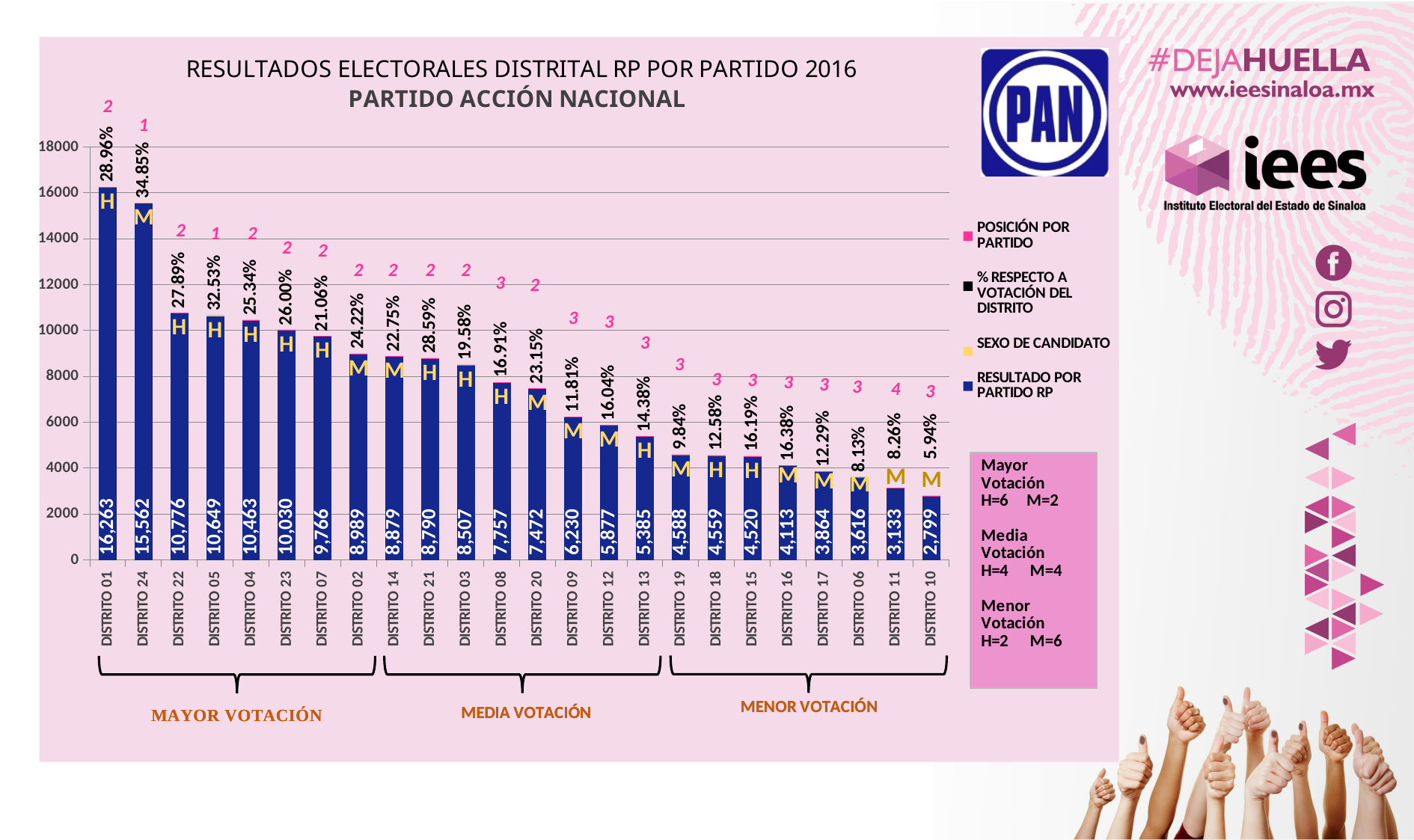
What percentage (% respecto a votación del distrito) is shown for DISTRITO 24? 34.85% Which has a larger value, DISTRITO 22 or DISTRITO 05? DISTRITO 22 How many districts are shown on the x axis of the chart? 24 What kind of chart is shown on the slide? bar chart What is the value for DISTRITO 13? 5,385 What is the difference between the values for DISTRITO 01 and DISTRITO 24? 701 Which district has the lowest RESULTADO POR PARTIDO RP value? DISTRITO 10 Do the bar values rise or fall from left to right along the x axis? fall What is the RESULTADO POR PARTIDO RP value for DISTRITO 01? 16,263 Which district has the highest RESULTADO POR PARTIDO RP value? DISTRITO 01 Is the value for DISTRITO 07 greater or less than 10000? less How many entries does the legend list? 4